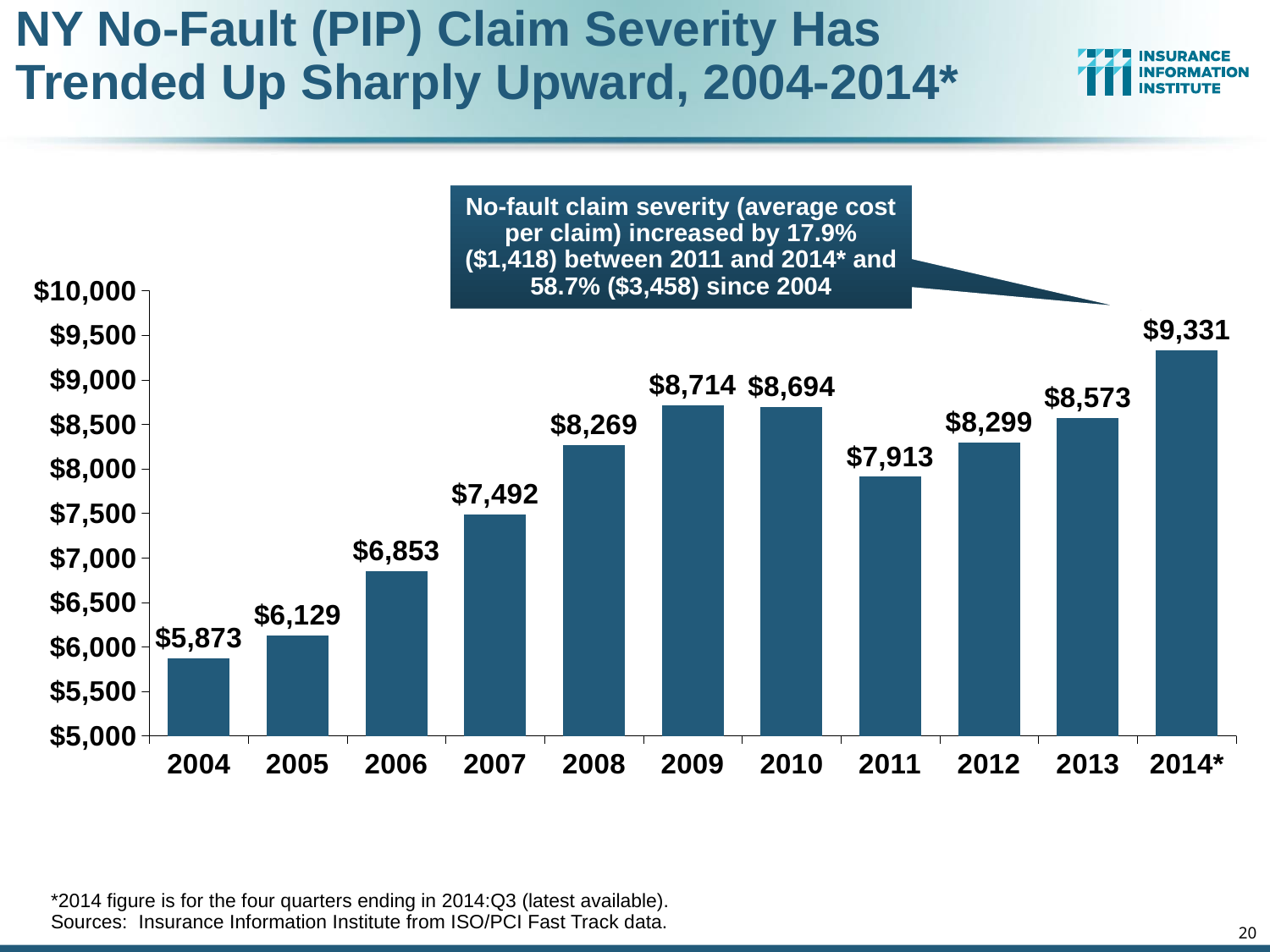
Which year has the highest claim severity? 2014* Which year has the lowest claim severity? 2004 How many years are shown on the x axis? 11 What is the difference between the 2009 value and the 2010 value? $20 What is the NY no-fault claim severity value for 2008? $8,269 What kind of chart is shown on the slide? bar chart What is the difference between the 2014* value and the 2013 value? $758 Is the value for 2007 greater or less than $7,000? greater Do the values generally rise or fall from 2004 to 2009? rise What is the claim severity value shown for 2011? $7,913 According to the callout box, by what percentage did no-fault claim severity increase since 2004? 58.7% Which is larger, the value for 2012 or the value for 2011? 2012